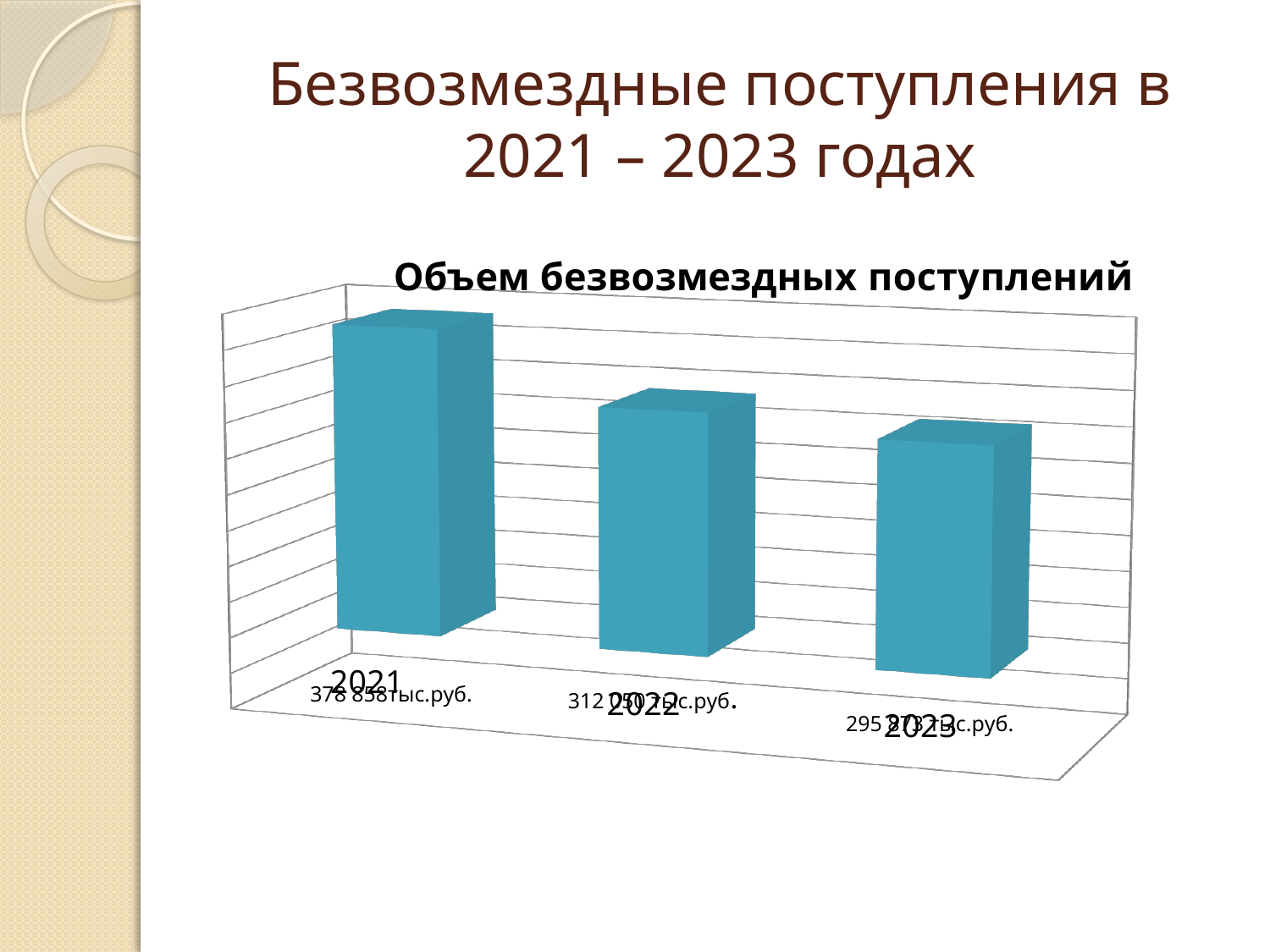
What colour are the bars in the chart? teal (blue-green) Which is larger, the value for 2022 or the value for 2023? 2022 Which is larger, the value for 2021 or the value for 2022? 2021 Do the values rise or fall from 2021 to 2023? fall What kind of chart is shown on the slide? bar chart How many years (categories) are plotted in the chart? 3 What is the title of the chart? Объем безвозмездных поступлений What is the value shown for 2021? 378 858тыс.руб. Which year has the highest volume of gratuitous receipts (безвозмездные поступления)? 2021 Which year has the lowest volume of gratuitous receipts? 2023